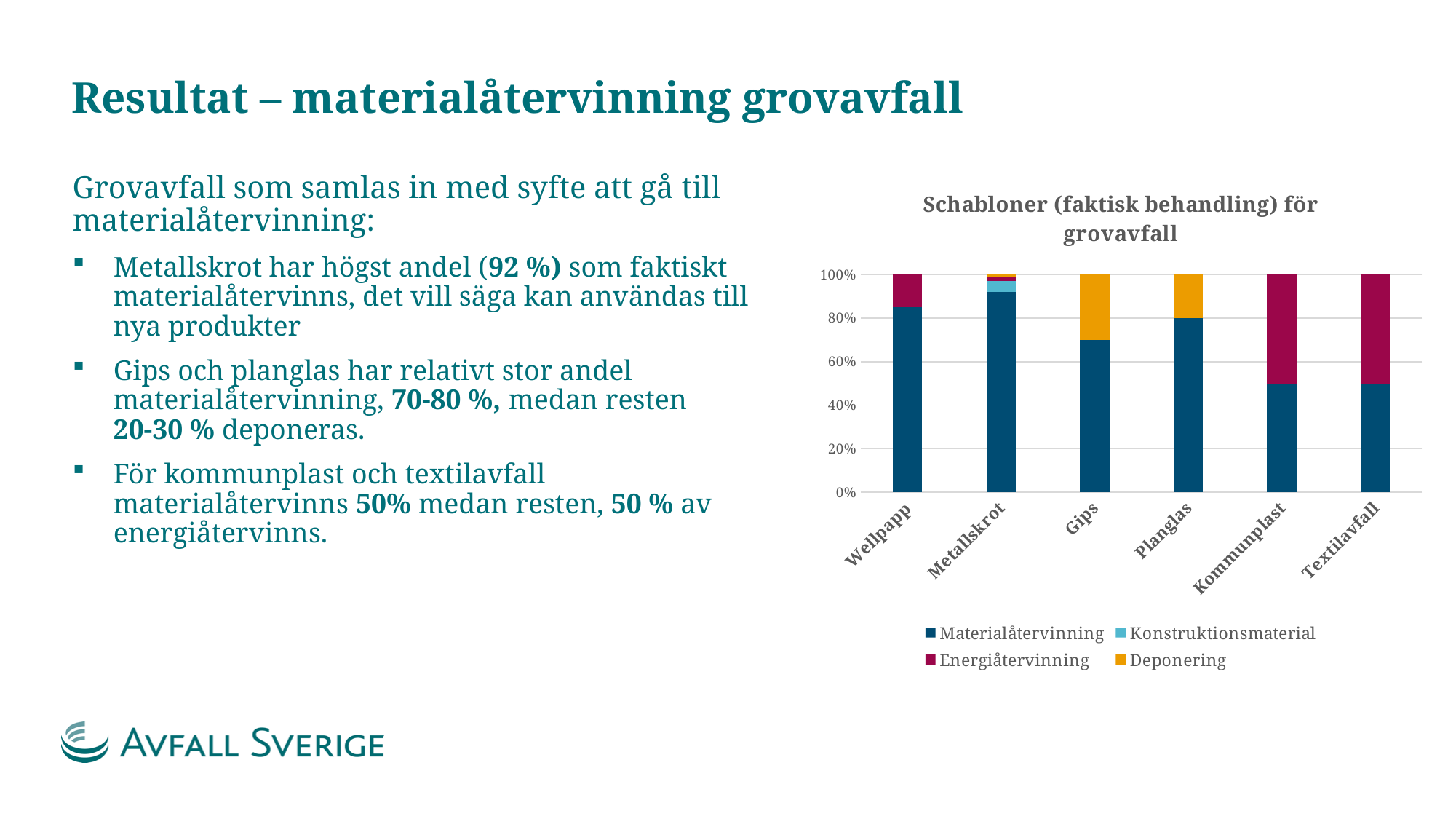
Which category has the highest Materialåtervinning share in the chart? Metallskrot How many series does the chart legend list? 4 Is the Energiåtervinning value for Textilavfall greater or less than 40%? greater How many categories are shown on the x axis of the chart? 6 What is the total height of the stacked bar for Gips? 100% Is the Materialåtervinning value for Gips greater or less than 80%? less Is the Materialåtervinning value for Wellpapp greater or less than 80%? greater Which series is shown in orange in the chart? Deponering What is the title of the chart? Schabloner (faktisk behandling) för grovavfall What kind of chart is shown on the slide? Stacked bar chart Which has the larger Materialåtervinning share, Gips or Planglas? Planglas